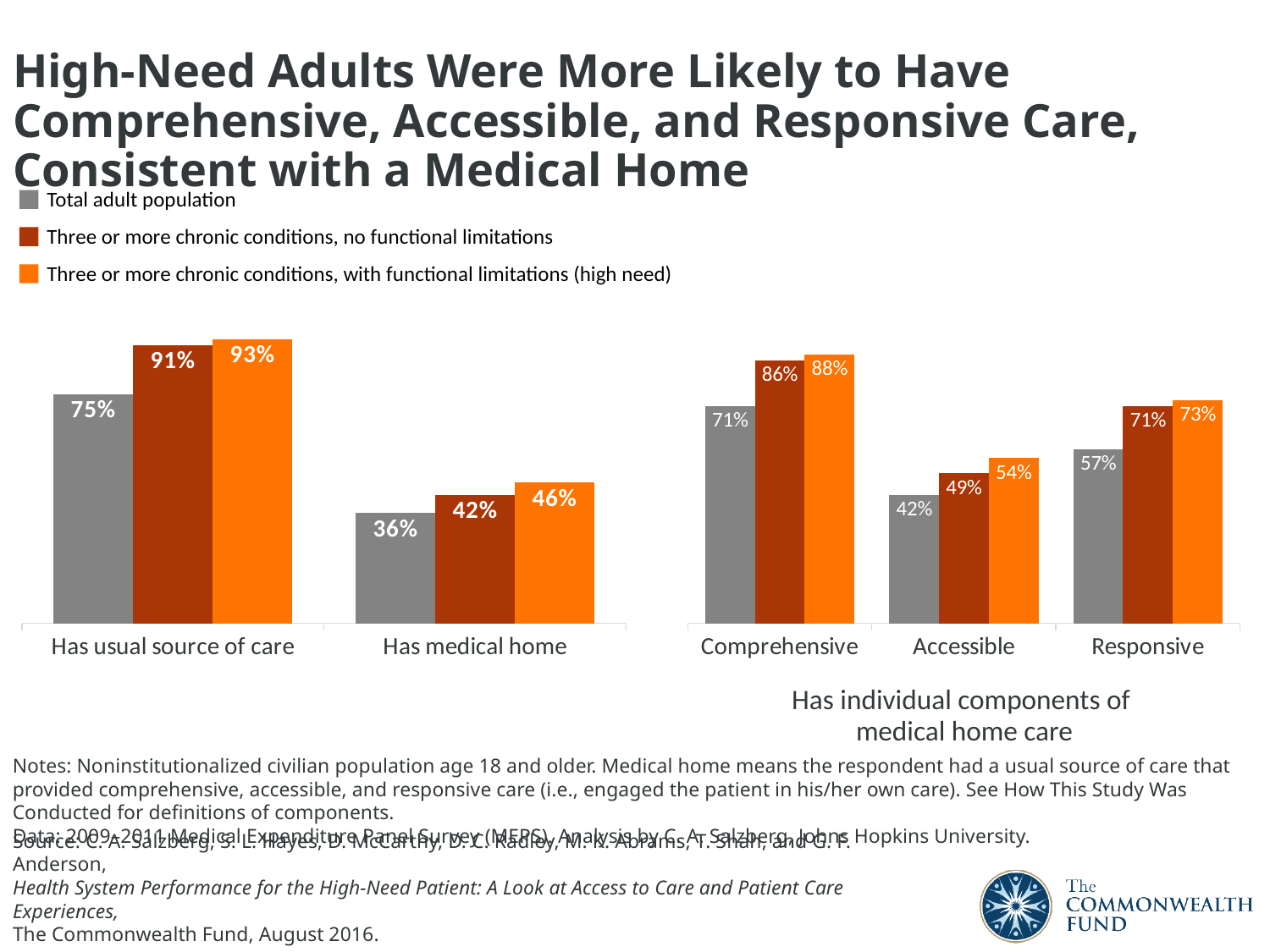
How many series does the legend list? 3 In the right chart ('Has individual components of medical home care'), what is the value for the total adult population for 'Accessible'? 42% In the right chart, what is the value for adults with three or more chronic conditions, no functional limitations, for 'Responsive'? 71% In the right chart, which component has the highest value for the high-need group? Comprehensive In the left chart, what is the difference between the high-need group and the total adult population for 'Has usual source of care'? 18 percentage points In the left chart, which is larger: the total adult population value for 'Has medical home' or the high-need value for 'Has medical home'? High-need value (46%) In the left chart, what is the value for adults with three or more chronic conditions and functional limitations (high need) for 'Has medical home'? 46% In the right chart, which component has the lowest value for the total adult population? Accessible How many categories are shown in the right chart? 3 In the right chart, what is the difference between the high-need group and the total adult population for 'Comprehensive'? 17 percentage points What type of chart is used on this slide? Bar chart In the left chart, what percentage of the total adult population has a usual source of care? 75%